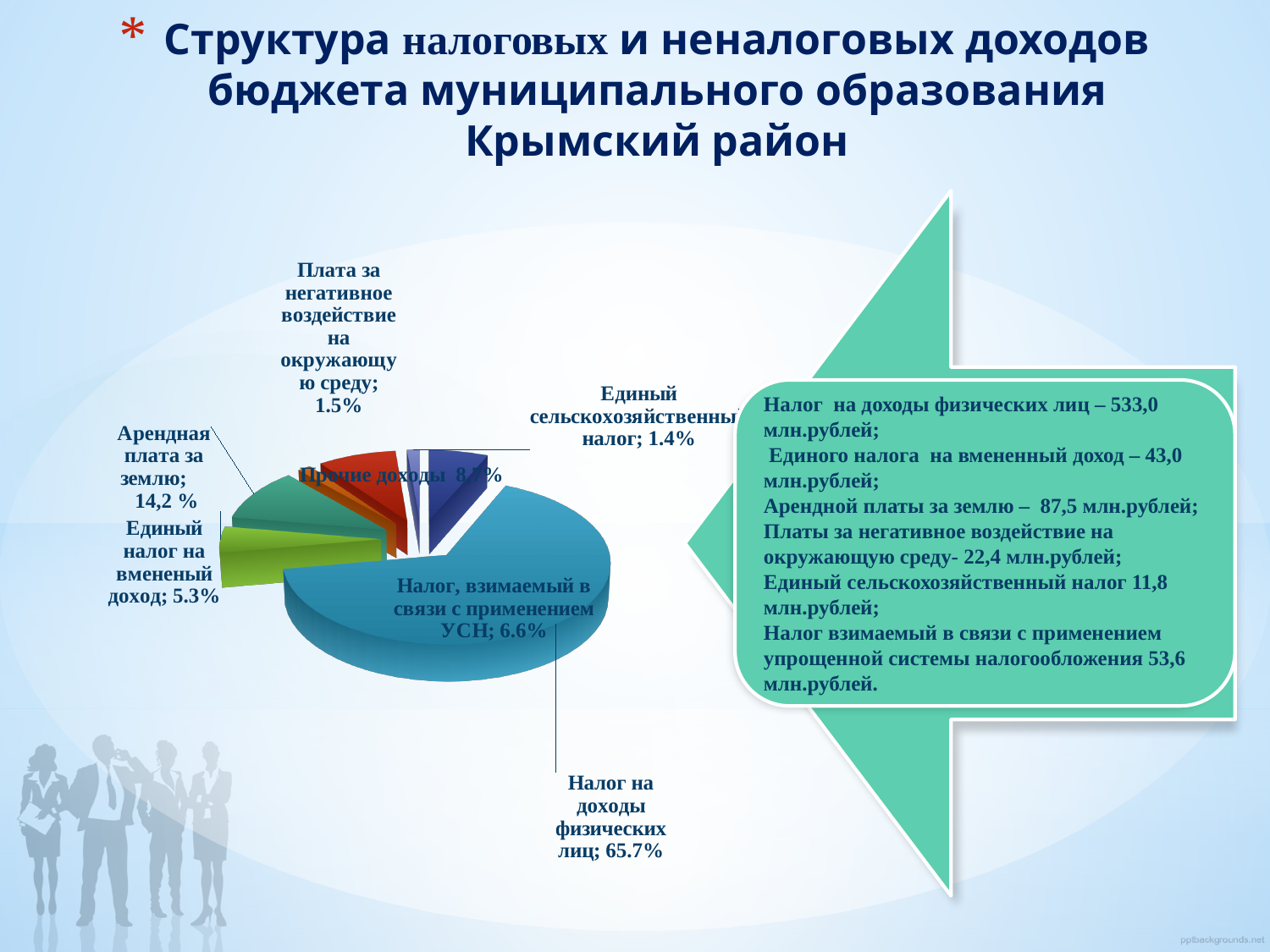
What is the value shown for Плата за негативное воздействие на окружающую среду? 1.5% What is the value shown for Налог, взимаемый в связи с применением УСН? 6.6% What is the value shown for Единый сельскохозяйственный налог? 1.4% Which category has the largest share of the pie? Налог на доходы физических лиц What kind of chart is shown on the slide? pie chart Which is larger: the share for Единый налог на вмененый доход or the share for Налог, взимаемый в связи с применением УСН? Налог, взимаемый в связи с применением УСН What is the value shown for Единый налог на вмененый доход? 5.3% Which category has the smallest share of the pie? Единый сельскохозяйственный налог What is the value shown for Арендная плата за землю? 14,2 % What share of the pie does Налог на доходы физических лиц have? 65.7% What is the difference in percentage points between Налог на доходы физических лиц and Арендная плата за землю? 51.5 How many slices does the pie chart have? 7